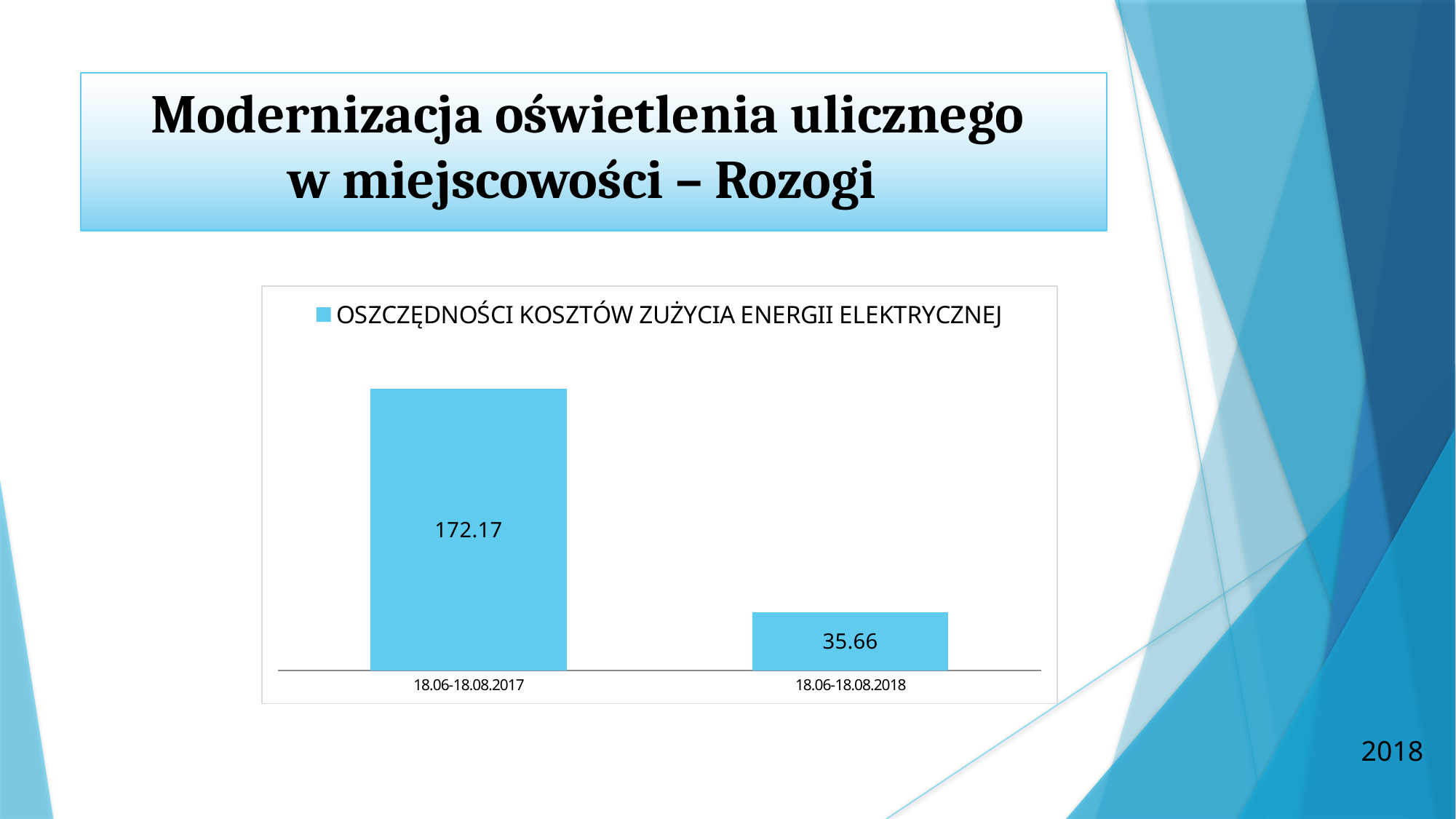
What colour are the bars in the chart? light blue What is the value for 18.06-18.08.2018? 35.66 Do the values rise or fall from 18.06-18.08.2017 to 18.06-18.08.2018? fall What is the value for 18.06-18.08.2017? 172.17 Which category has the highest value? 18.06-18.08.2017 How many categories are shown on the x axis? 2 What is the difference between the values for 18.06-18.08.2017 and 18.06-18.08.2018? 136.51 What is the name of the series shown in the legend? OSZCZĘDNOŚCI KOSZTÓW ZUŻYCIA ENERGII ELEKTRYCZNEJ How many series does the legend list? 1 Which is larger, the value for 18.06-18.08.2017 or for 18.06-18.08.2018? 18.06-18.08.2017 What kind of chart is shown on the slide? bar chart Which category has the lowest value? 18.06-18.08.2018